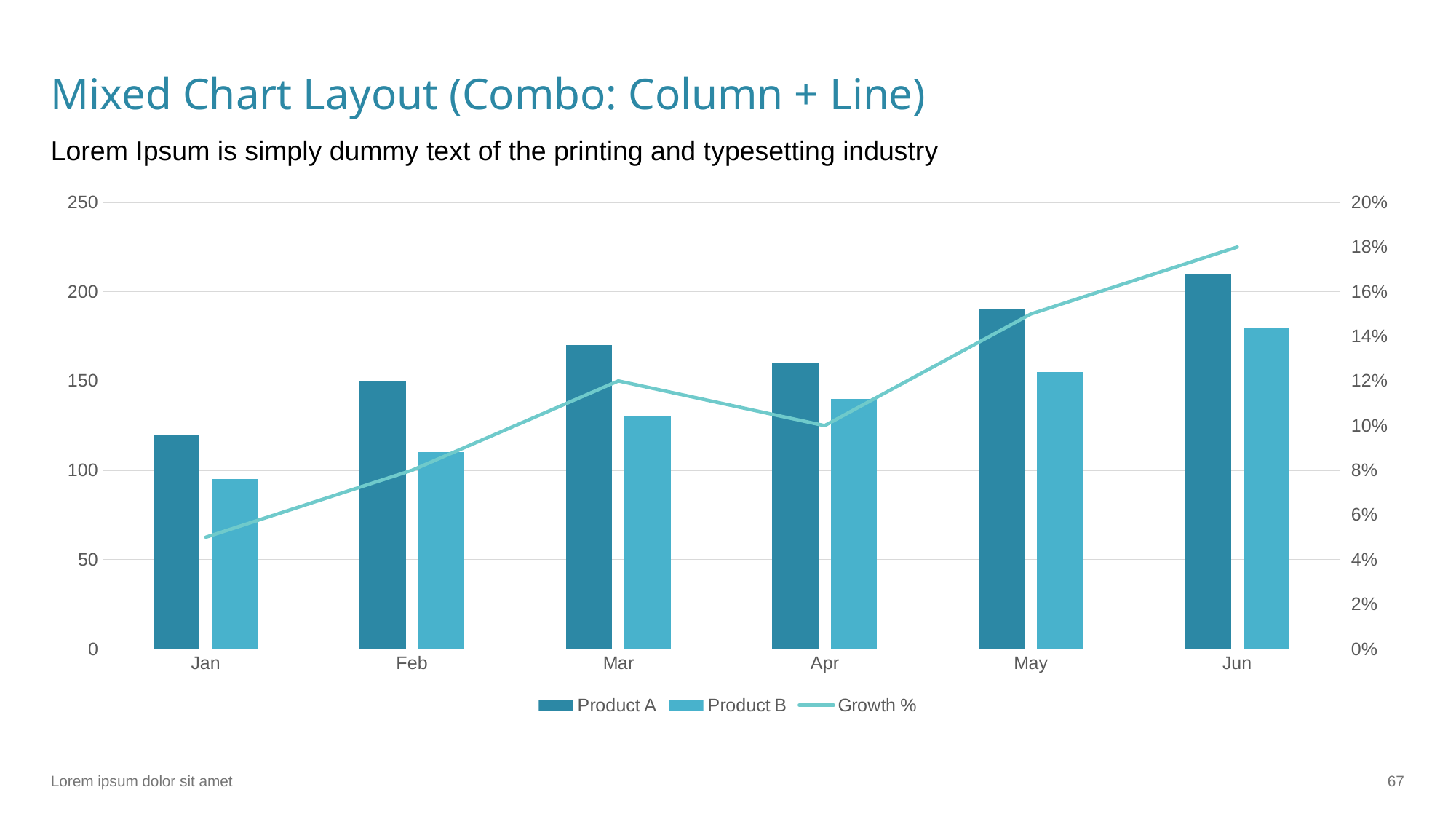
Is the value for Product A in Jun greater or less than 200? greater Which month has the highest Product A value? Jun How many series does the legend list? 3 Which is larger in Apr, Product A or Product B? Product A How many months are shown on the x axis? 6 Is the Growth % value in May greater or less than 14%? greater What is the Growth % value in Mar? 12% Does the Product A series generally rise or fall from Jan to Jun? rise What is the Growth % value in Jun? 18% Which month has the lowest Product B value? Jan Is the value for Product B in Jan greater or less than 100? less What is the value for Product A in Feb? 150